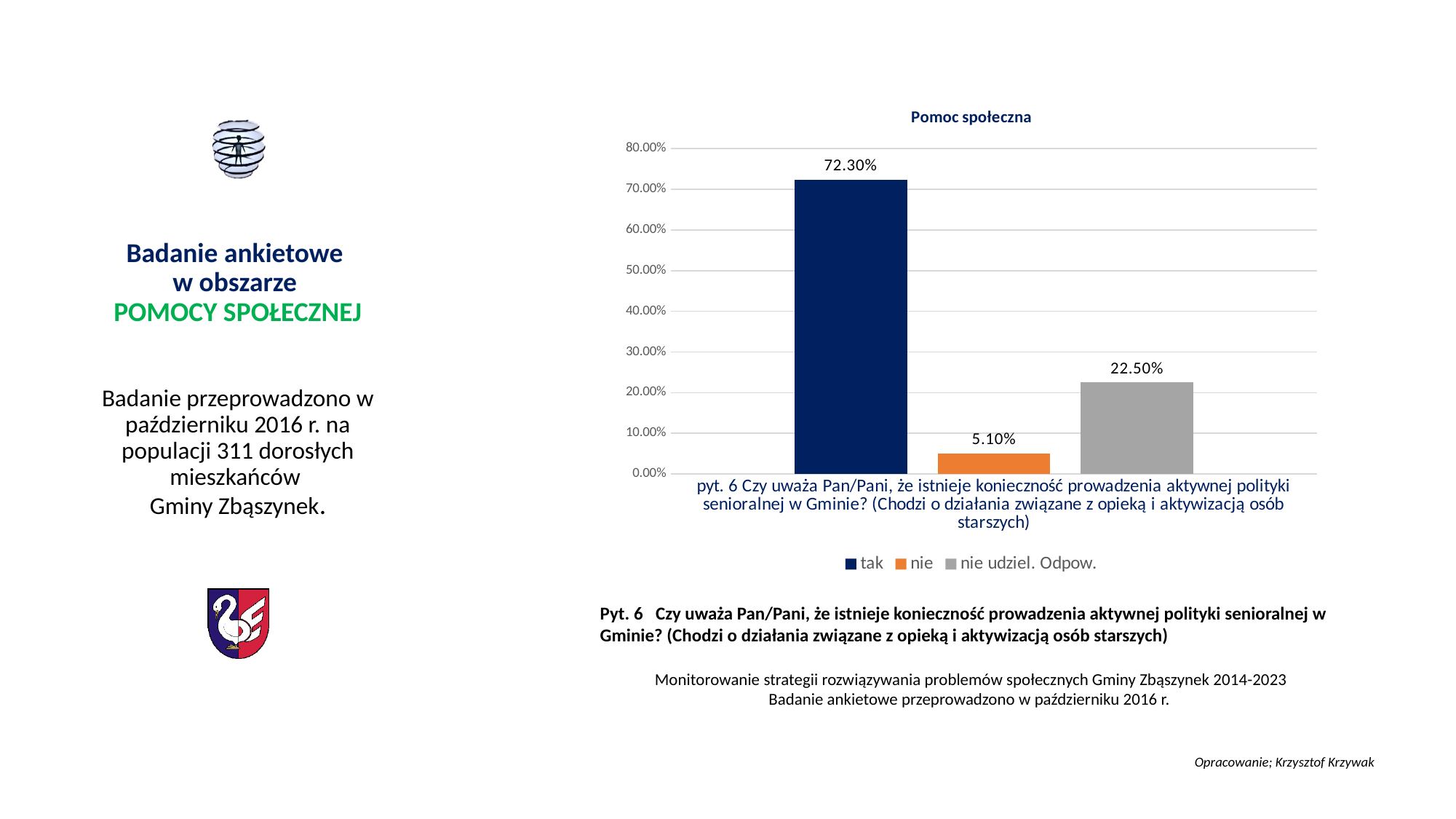
What is the title of the chart? Pomoc społeczna Which series has the lowest value? nie What is the difference between the values for "nie udziel. Odpow." and "nie"? 17.40% Which series has the highest value? tak What is the value for "nie"? 5.10% What is the difference between the values for "tak" and "nie udziel. Odpow."? 49.80% What is the value for "nie udziel. Odpow."? 22.50% Which is larger, the value for "nie" or the value for "nie udziel. Odpow."? nie udziel. Odpow. Is the value for "tak" greater or less than 70.00%? greater What is the value for "tak"? 72.30% What kind of chart is shown on the slide? bar chart How many series does the legend list? 3